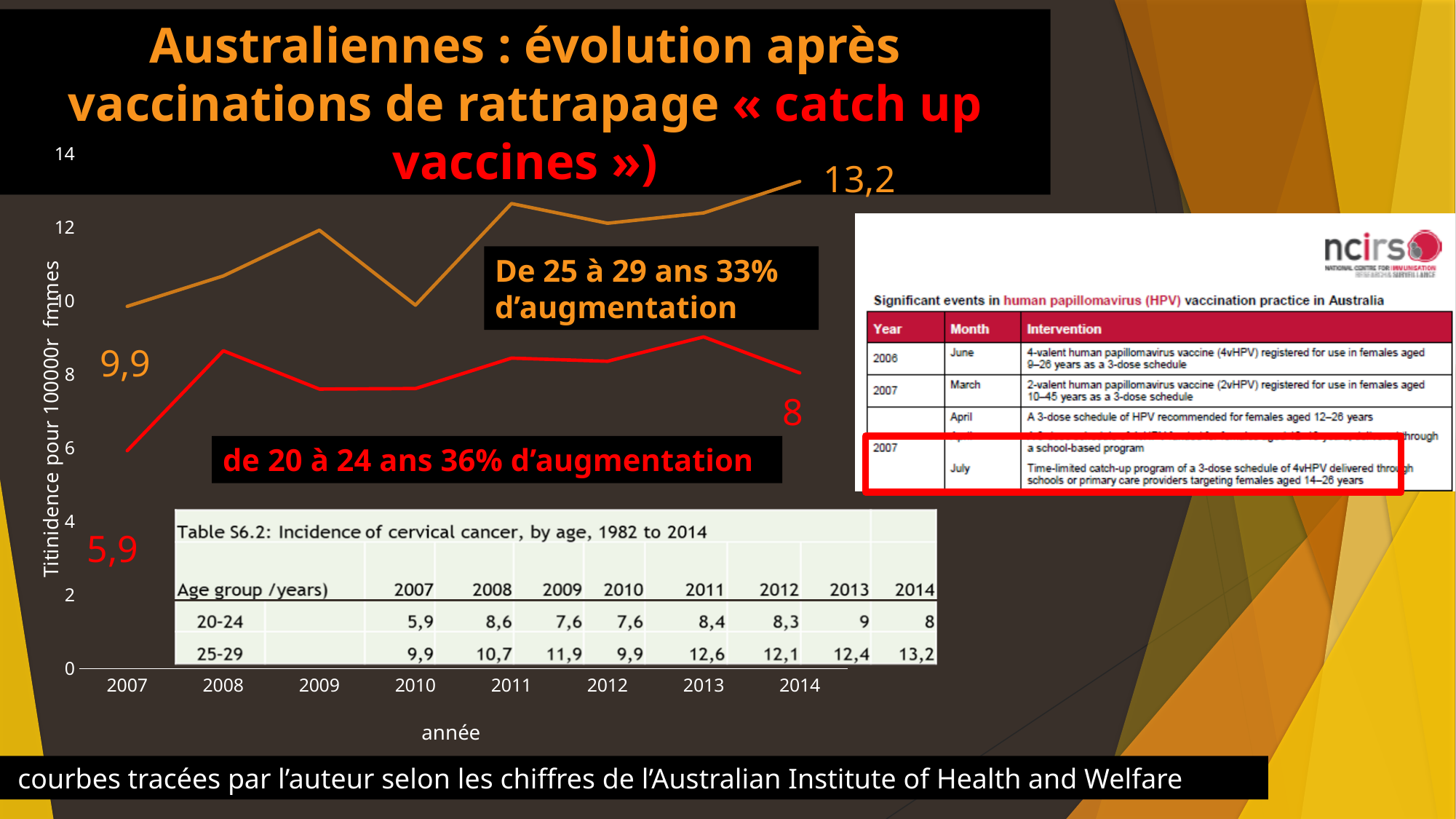
What is the labelled value of the red line (20 à 24 ans) in 2007? 5,9 In which year does the red line (20 à 24 ans) reach its lowest value? 2007 What type of chart is shown on the slide? line chart In 2014, which line has the higher value, the orange (25 à 29 ans) or the red (20 à 24 ans)? orange (25 à 29 ans) By how much did the orange line (25 à 29 ans) increase between 2007 and 2014? 3,3 What is the labelled value of the orange line (25 à 29 ans) in 2007? 9,9 What is the labelled value of the orange line (25 à 29 ans) in 2014? 13,2 What is the title of the x axis of the chart? année How many years are plotted along the x axis of the chart? 8 What is the labelled value of the red line (20 à 24 ans) in 2014? 8 By how much did the red line (20 à 24 ans) increase between 2007 and 2014? 2,1 Is the value of the orange line (25 à 29 ans) in 2009 greater or less than 10? greater